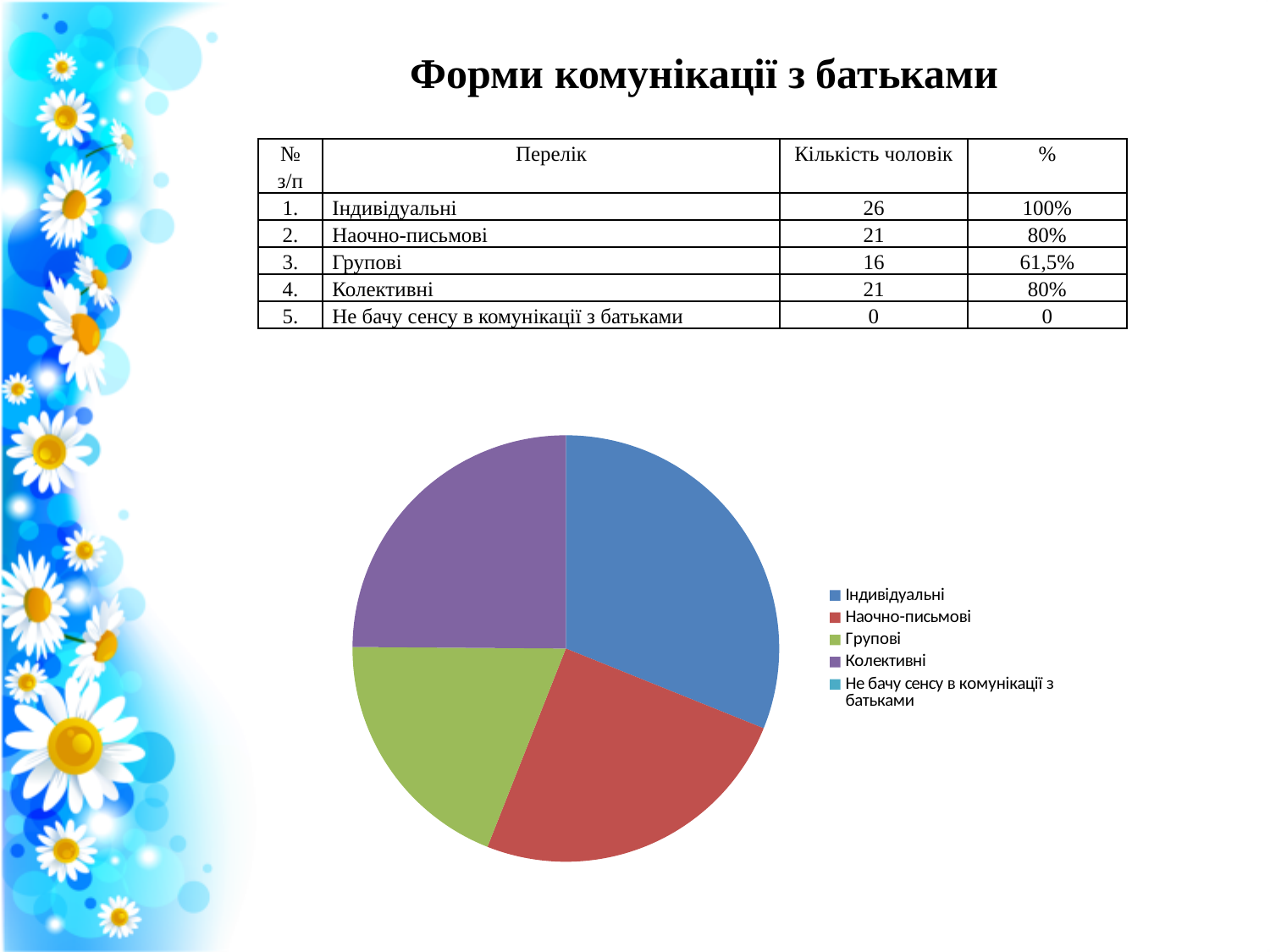
According to the table, how many people (Кількість чоловік) chose Індивідуальні? 26 Which of the visible slices in the pie chart is the smallest? Групові How many categories does the pie chart's legend list? 5 According to the table, what percentage corresponds to Групові? 61,5% What kind of chart is shown on the slide? pie chart According to the table, how many people chose Групові? 16 Using the table values, what is the difference in number of people between Індивідуальні and Групові? 10 Which category has the largest slice in the pie chart? Індивідуальні What is the title of the slide containing the pie chart? Форми комунікації з батьками What colour is the slice for Індивідуальні in the pie chart? blue Which is larger in the pie chart, the slice for Індивідуальні or the slice for Групові? Індивідуальні According to the table, how many people chose 'Не бачу сенсу в комунікації з батьками'? 0